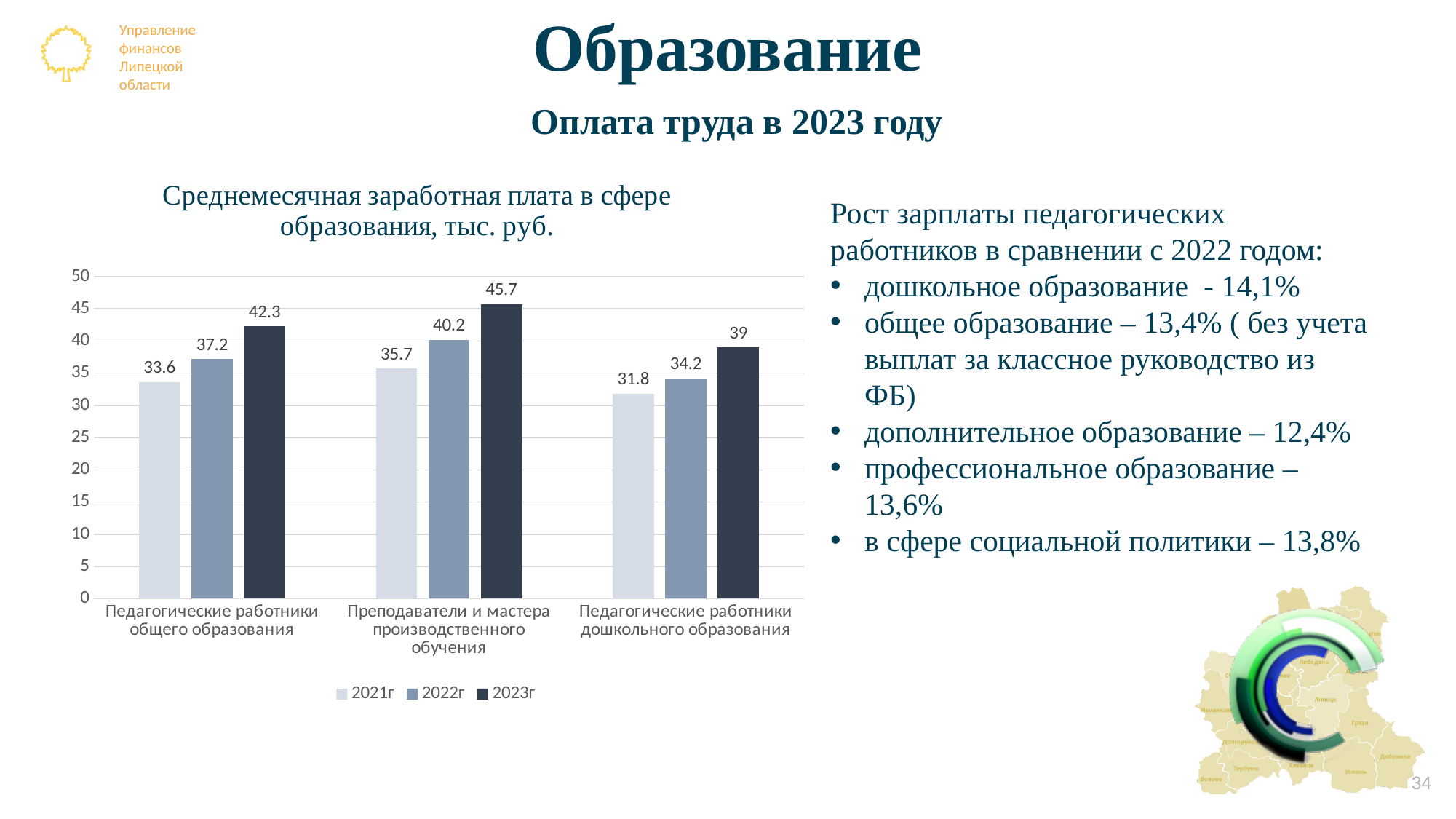
What is the difference between the 2023г and 2022г values for Педагогические работники общего образования? 5.1 Which category has the lowest 2021г value? Педагогические работники дошкольного образования Is the 2023г value for Педагогические работники дошкольного образования greater or less than 40? less What is the title of the chart? Среднемесячная заработная плата в сфере образования, тыс. руб. How many categories are shown on the x axis of the chart? 3 What is the 2023г value for Преподаватели и мастера производственного обучения? 45.7 What is the 2021г value for Педагогические работники дошкольного образования? 31.8 Which is larger: the 2022г value for Преподаватели и мастера производственного обучения or the 2023г value for Педагогические работники дошкольного образования? 2022г value for Преподаватели и мастера производственного обучения (40.2) What kind of chart is shown on the slide? bar chart How many series does the chart legend list? 3 Which category has the highest 2023г value? Преподаватели и мастера производственного обучения What is the 2022г value for Педагогические работники общего образования? 37.2